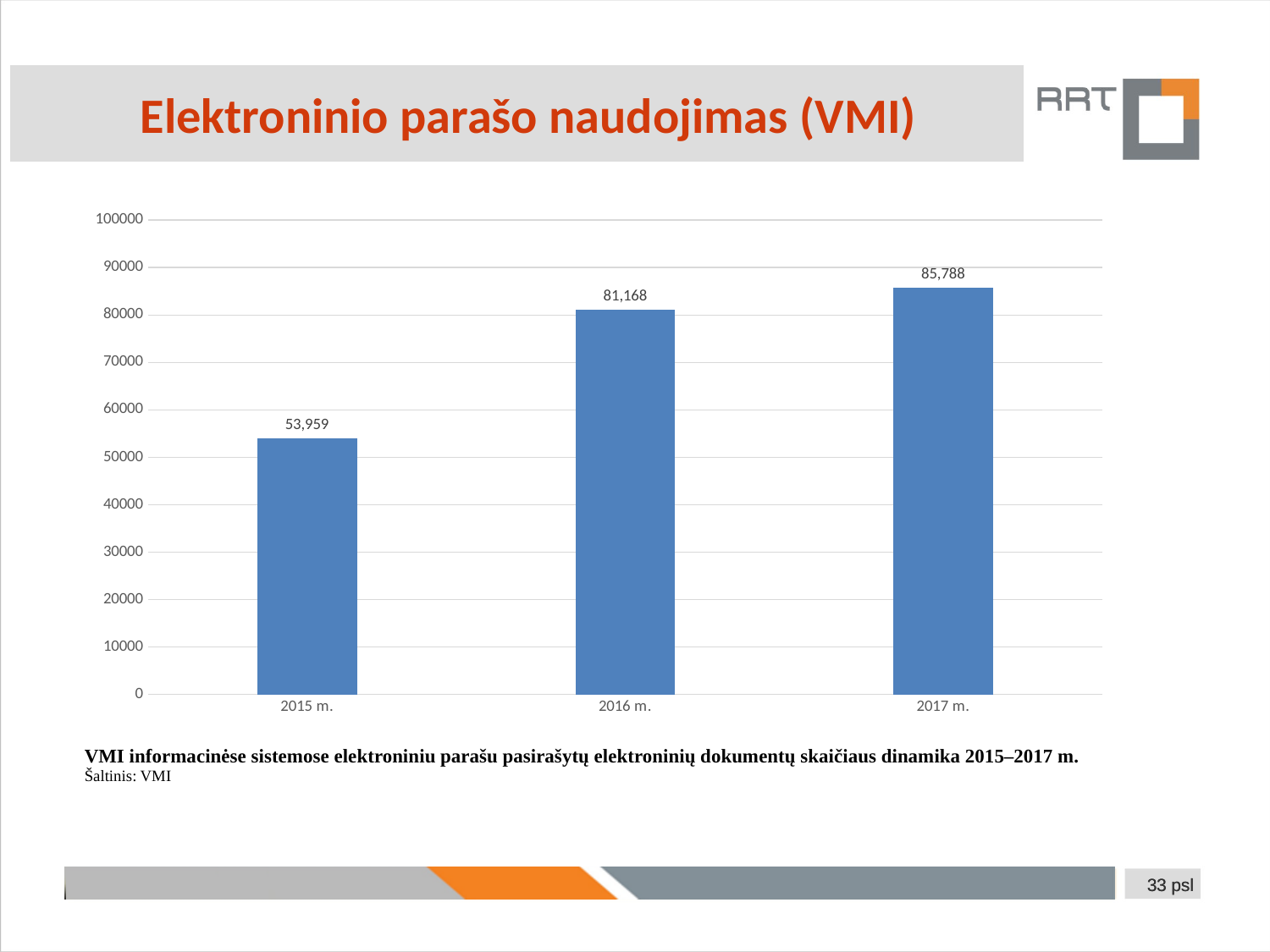
What is the difference between the values for 2017 m. and 2016 m.? 4,620 What is the value for 2016 m.? 81,168 Is the value for 2015 m. greater or less than 60000? less Which is larger, the value for 2015 m. or the value for 2016 m.? 2016 m. Do the values rise or fall from 2015 m. to 2017 m.? rise How many years are shown on the x axis? 3 What kind of chart is shown on the slide? bar chart What is the value for 2017 m.? 85,788 Which year has the lowest value? 2015 m. Which year has the highest value? 2017 m. What is the difference between the values for 2016 m. and 2015 m.? 27,209 What is the value for 2015 m.? 53,959